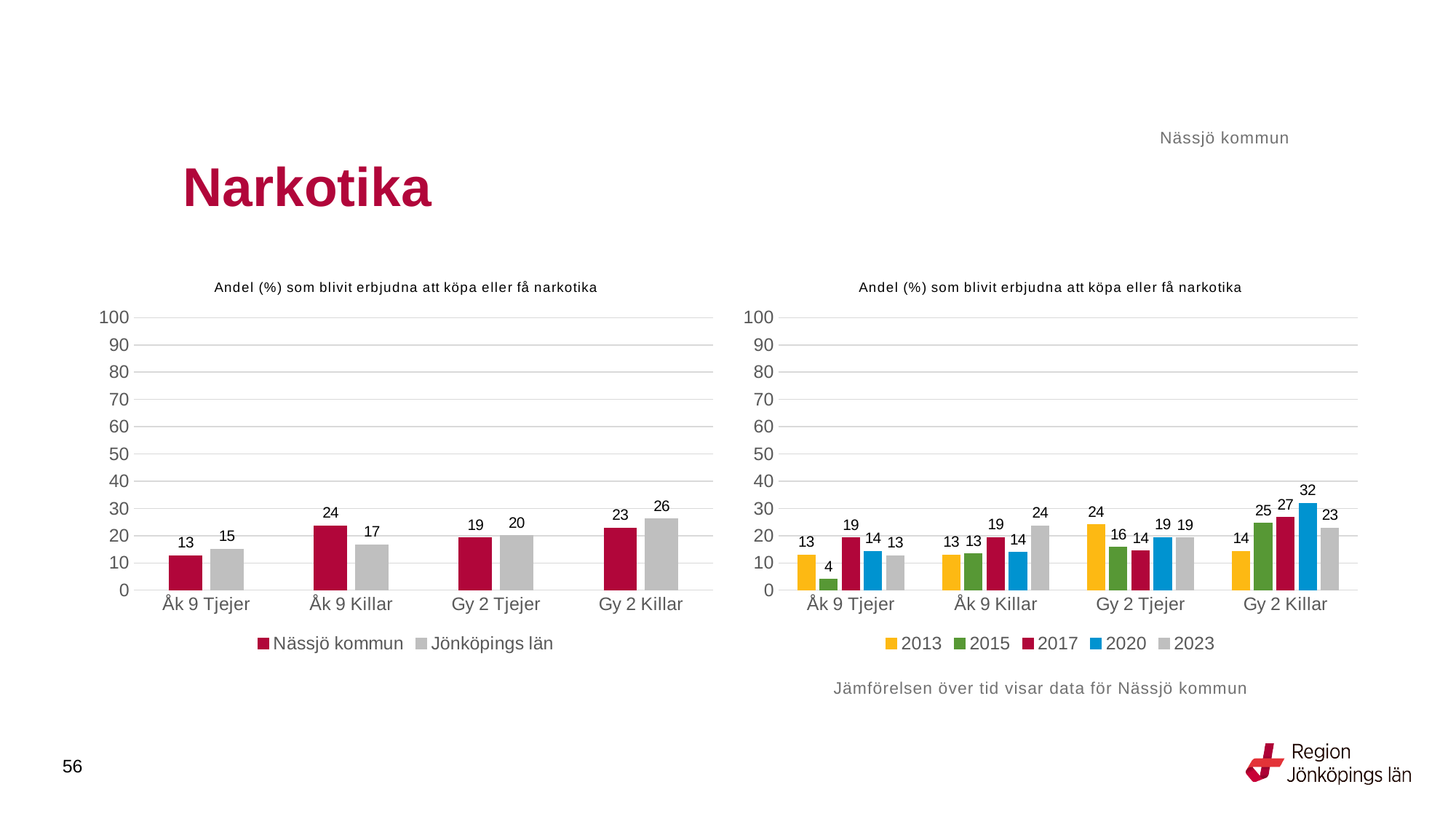
In the right chart, what is the value for 2015 for Åk 9 Tjejer? 4 What kind of chart is the right chart? Bar chart In the left chart, what is the value for Jönköpings län for Gy 2 Killar? 26 In the right chart, what is the difference between 2013 and 2023 for Åk 9 Killar? 11 In the left chart, what is the difference between Nässjö kommun and Jönköpings län for Åk 9 Killar? 7 In the right chart, which year has the lowest value for Åk 9 Tjejer? 2015 In the left chart, which category has the highest value for Jönköpings län? Gy 2 Killar In the right chart, what is the value for 2020 for Gy 2 Killar? 32 In the left chart, how many series does the legend list? 2 In the left chart, which is larger for Gy 2 Tjejer: Nässjö kommun or Jönköpings län? Jönköpings län In the right chart, how many series does the legend list? 5 In the left chart, what is the value for Nässjö kommun for Åk 9 Killar? 24